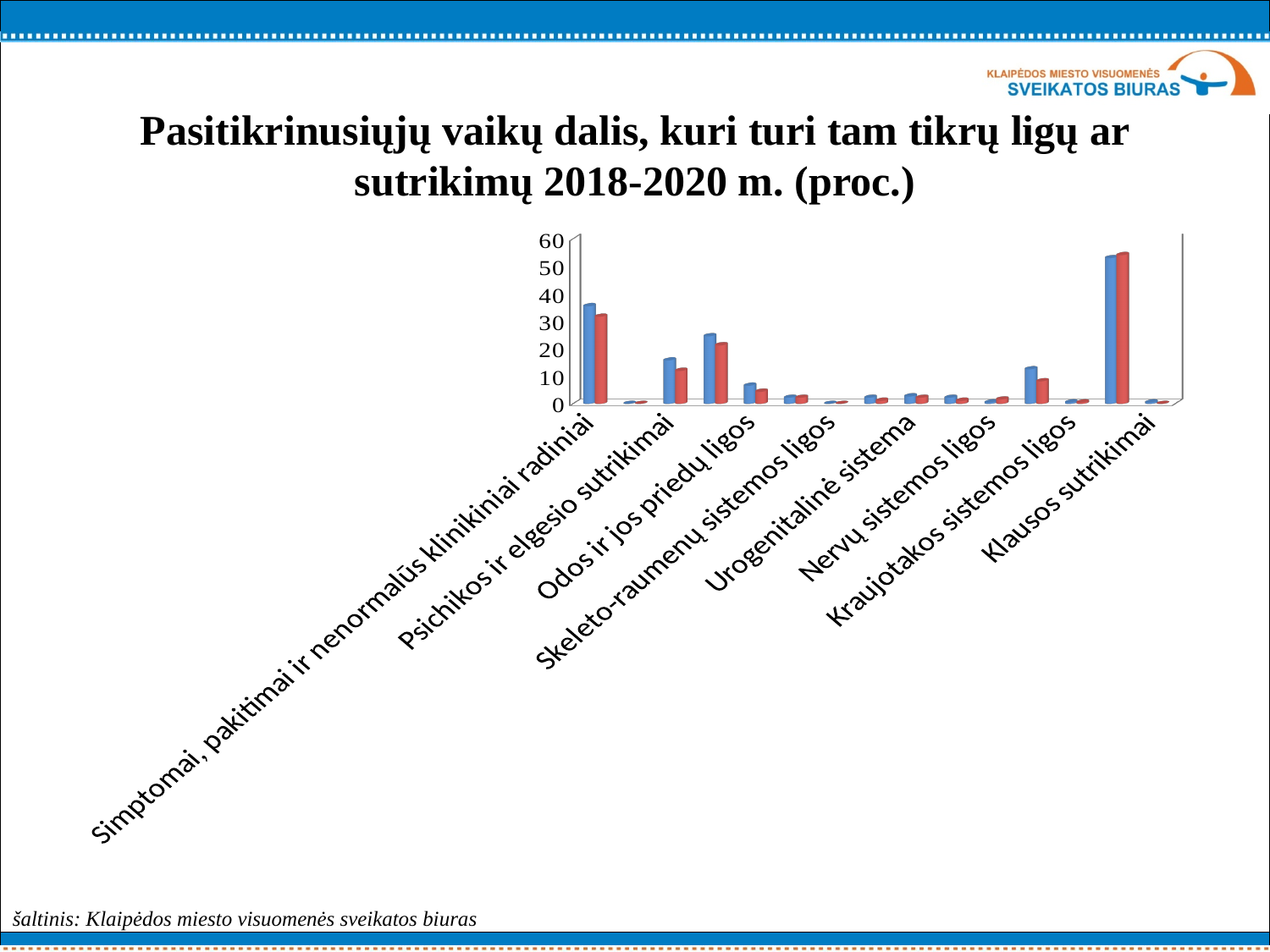
Is the value of the blue bar for 'Nervų sistemos ligos' greater or less than 10? less Is the value of the red bar for 'Simptomai, pakitimai ir nenormalūs klinikiniai radiniai' greater or less than 40? less Is the value of the blue bar for 'Psichikos ir elgesio sutrikimai' greater or less than 20? less What kind of chart is shown on the slide? bar chart For 'Simptomai, pakitimai ir nenormalūs klinikiniai radiniai', which bar is taller, the blue one or the red one? the blue one What is the title of the chart on the slide? Pasitikrinusiųjų vaikų dalis, kuri turi tam tikrų ligų ar sutrikimų 2018-2020 m. (proc.) What is the highest value shown on the vertical axis of the chart? 60